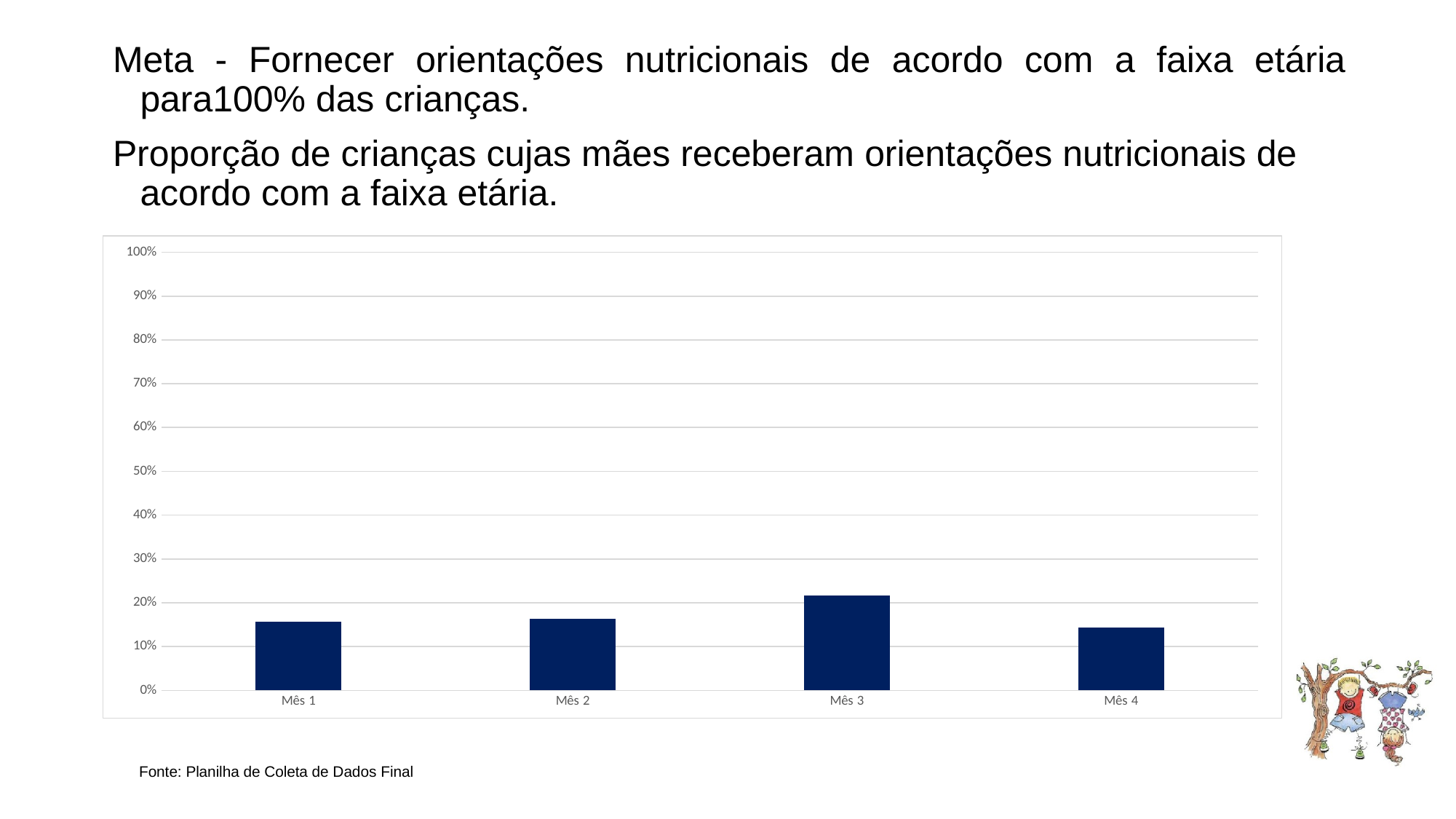
Which is larger, the value for Mês 3 or the value for Mês 1? Mês 3 Is the value for Mês 1 greater or less than 20%? less Which is larger, the value for Mês 3 or the value for Mês 4? Mês 3 Is the value for Mês 3 greater or less than 20%? greater Do any of the bars in the chart reach the 100% target shown at the top of the axis? No What source is cited below the chart? Planilha de Coleta de Dados Final What kind of chart is shown on the slide? bar chart Which month has the highest proportion in the chart? Mês 3 What is the label of the first category on the x axis? Mês 1 How many months (categories) are plotted on the x axis of the chart? 4